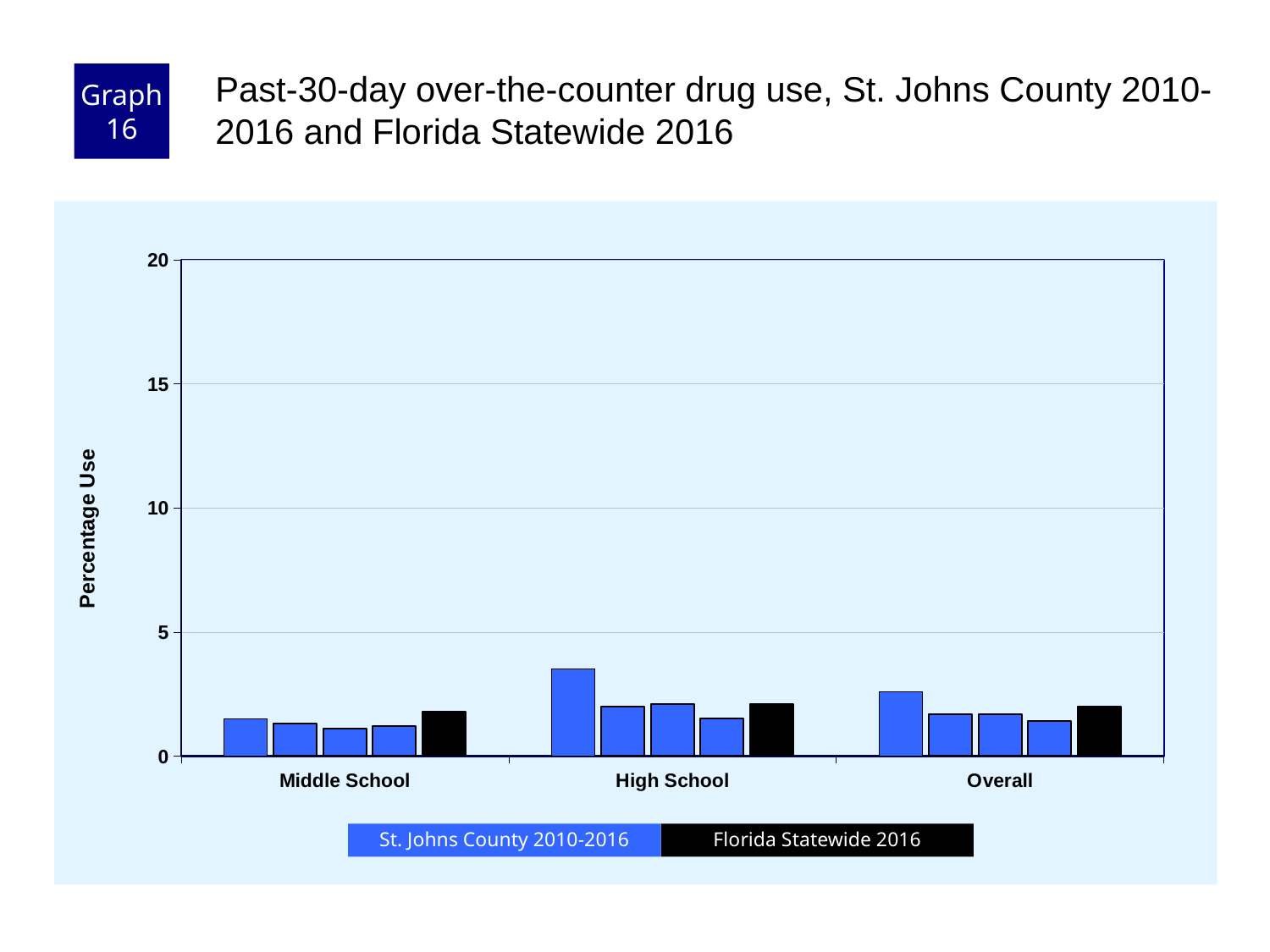
Is the tallest St. Johns County bar for High School greater or less than 5? less How many series does the legend list? 2 Which category contains the tallest bar in the chart? High School Which is larger: the tallest St. Johns County bar for High School or the tallest St. Johns County bar for Middle School? High School How many categories are shown on the x axis? 3 Is the Florida Statewide 2016 value for Overall greater or less than 5? less Which series is shown in black? Florida Statewide 2016 What is the label on the y axis? Percentage Use Is the Florida Statewide 2016 value for High School greater or less than 5? less Which is larger: the Florida Statewide 2016 bar for High School or the Florida Statewide 2016 bar for Middle School? High School What kind of chart is shown on the slide? bar chart